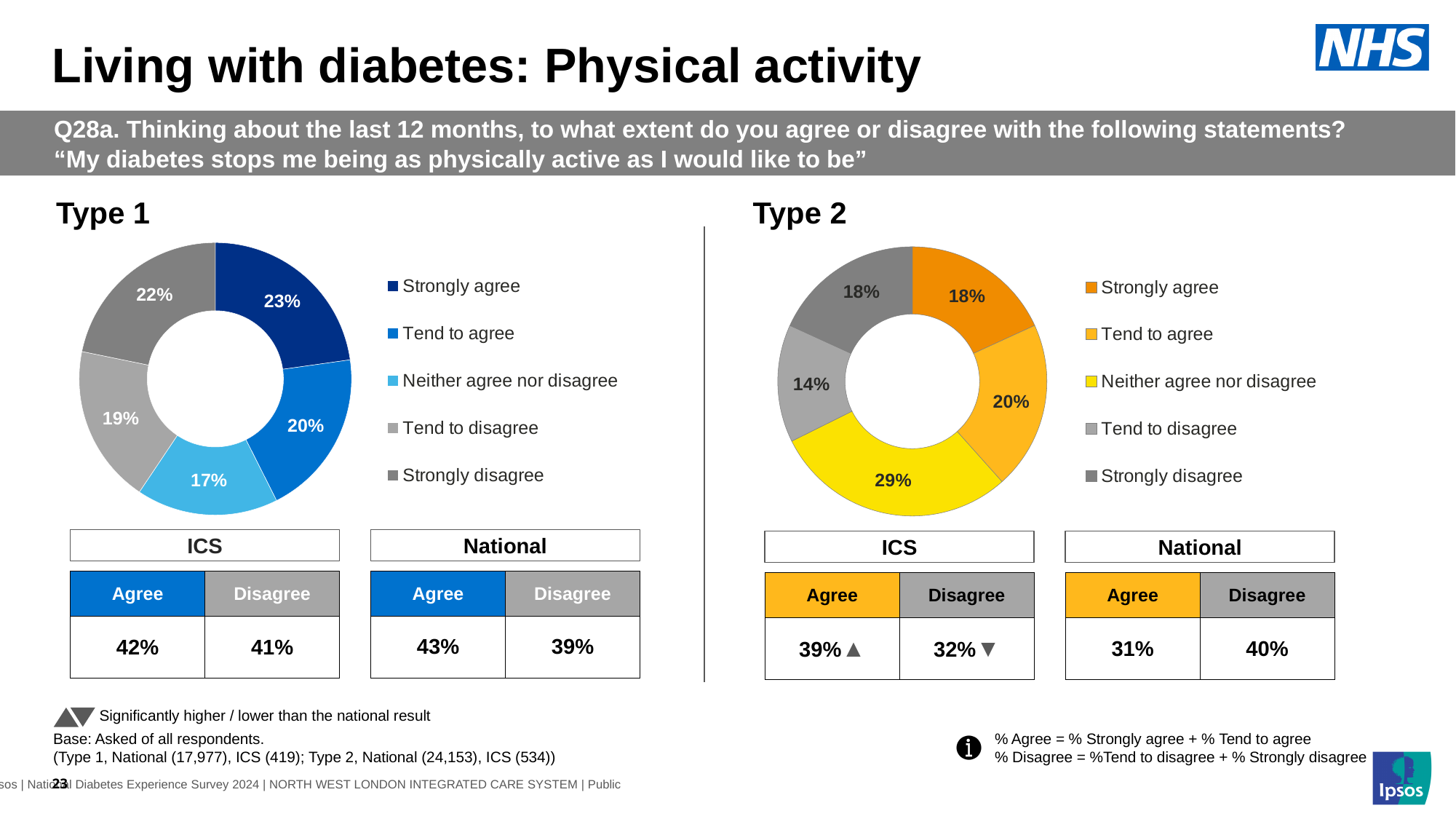
How many response categories does the legend of the Type 2 chart list? 5 In the Type 1 chart, what percentage of respondents neither agree nor disagree? 17% What kind of chart is used for the Type 1 data? Doughnut (pie) chart In the Type 1 chart, what percentage of respondents strongly agree? 23% In the Type 1 chart, what is the difference between the Strongly disagree share and the Tend to disagree share? 3% In the Type 2 chart, what percentage of respondents tend to disagree? 14% In the Type 2 chart, which response category has the smallest share? Tend to disagree In the Type 2 chart, what percentage of respondents neither agree nor disagree? 29% In the Type 2 chart, which is larger: the Tend to agree share or the Strongly agree share? Tend to agree In the Type 1 chart, which response category has the largest share? Strongly agree In the Type 2 chart, which response category has the largest share? Neither agree nor disagree In the Type 1 chart, which response category has the smallest share? Neither agree nor disagree